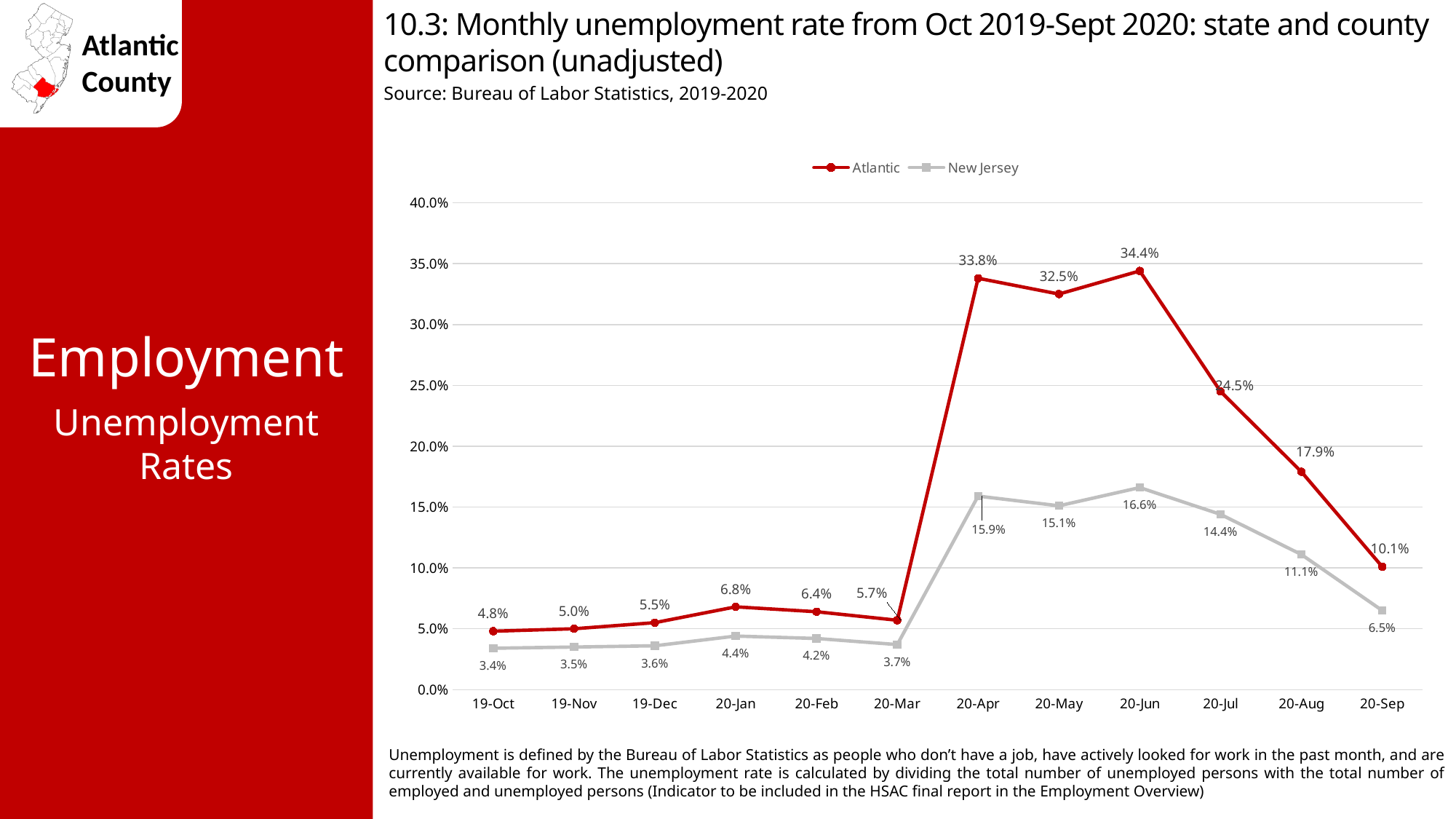
How many months are plotted on the x axis? 12 Which series had the higher value in 20-Sep, Atlantic or New Jersey? Atlantic In which month was the New Jersey unemployment rate lowest? 19-Oct How many series does the legend list? 2 Did the Atlantic unemployment rate rise or fall from 20-Jun to 20-Sep? Fall What was the Atlantic unemployment rate in 20-Apr? 33.8% What was the New Jersey unemployment rate in 20-Jun? 16.6% What was the Atlantic unemployment rate in 19-Oct? 4.8% What kind of chart is shown on the slide? Line chart In which month did the Atlantic series reach its highest value? 20-Jun What is the difference between the Atlantic and New Jersey rates in 20-Jul? 10.1% Is the Atlantic value for 20-Aug greater or less than 15.0%? greater